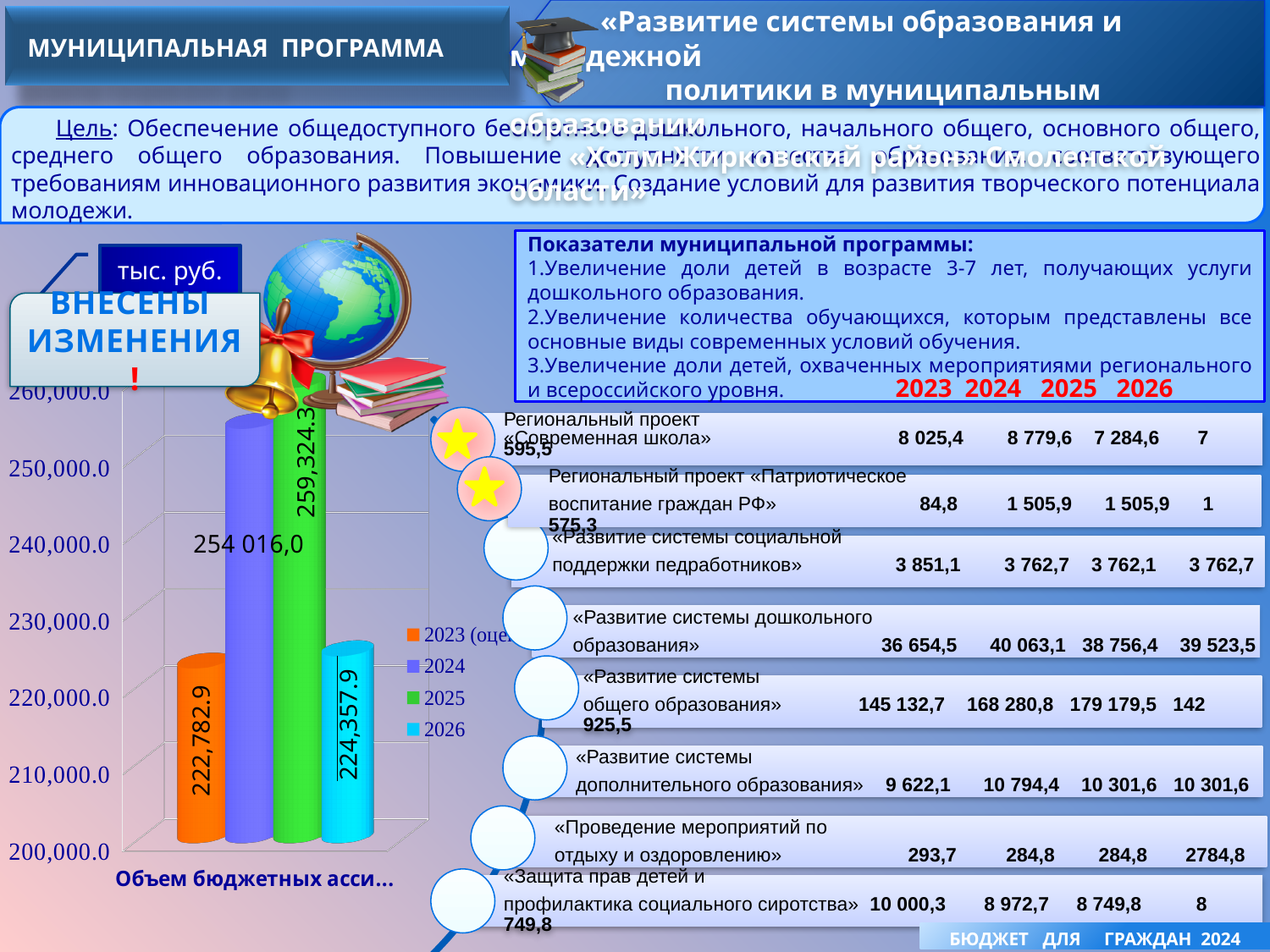
What is the value of the 2025 bar in the chart? 259,324.3 What is the difference between the 2025 bar and the 2023 bar in the chart? 36,541.4 Which is larger in the chart, the 2024 bar or the 2026 bar? 2024 What type of chart is shown on the slide? bar chart What value is labelled on the 2024 bar in the chart? 254 016,0 What is the value of the 2023 (оценка) bar in the chart? 222,782.9 Is the value for 2026 in the chart greater or less than 230,000.0? less What value is labelled on the 2026 bar in the chart? 224,357.9 Which year has the highest bar in the chart? 2025 How many bars are plotted in the chart? 4 Which year has the lowest bar in the chart? 2023 Is the value for 2024 in the chart greater or less than 250,000.0? greater